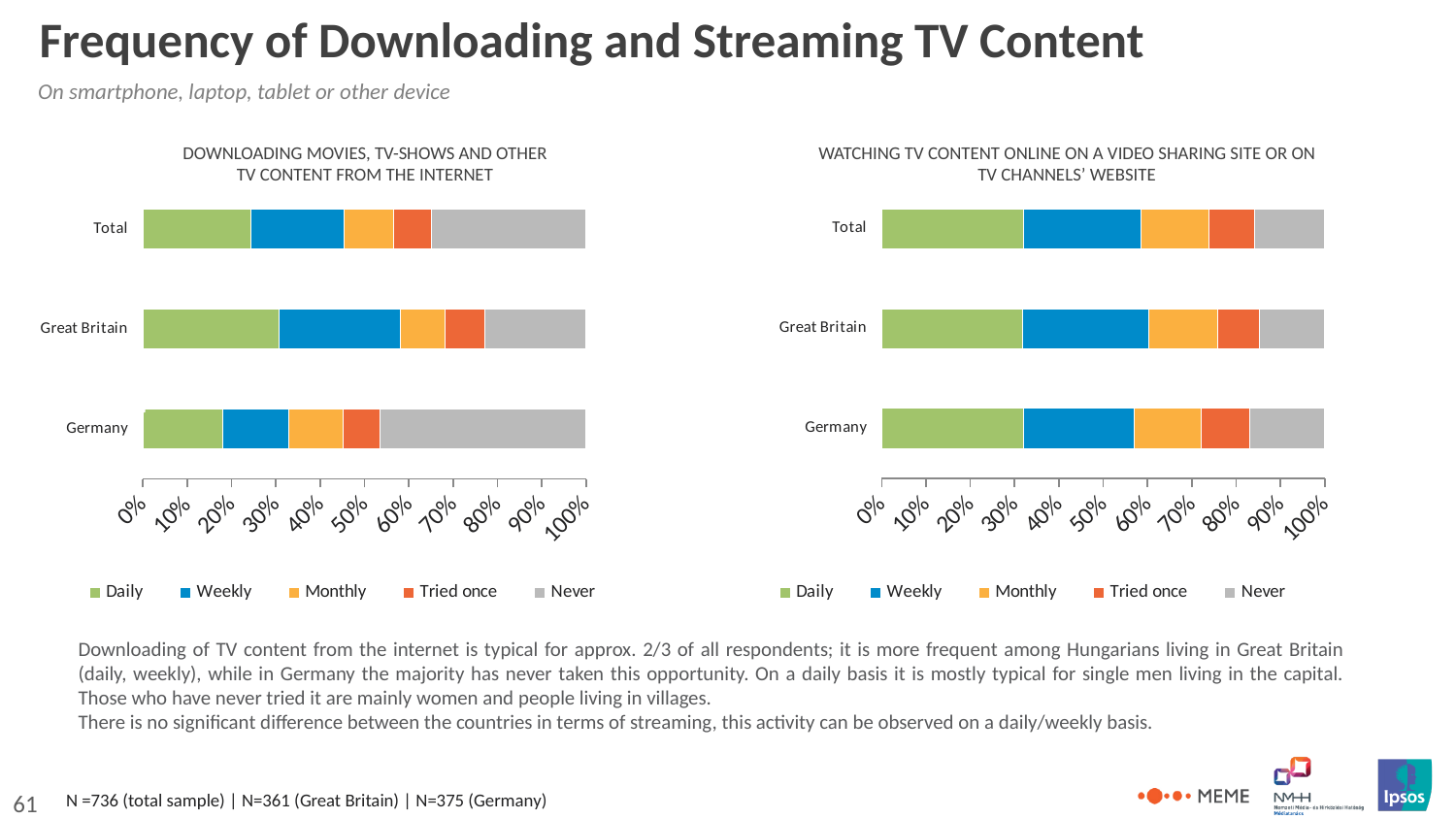
In the left chart, 'Downloading movies, TV-shows and other TV content from the internet', is the Daily share for Great Britain larger or smaller than the Daily share for Germany? Larger In the left chart, 'Downloading movies, TV-shows and other TV content from the internet', which category has the smallest Daily share? Germany In the left chart, 'Downloading movies, TV-shows and other TV content from the internet', which category has the largest Never share? Germany In the right chart, 'Watching TV content online on a video sharing site or on TV channels' website', is the Never share for Germany greater or less than 30%? less In the right chart, 'Watching TV content online on a video sharing site or on TV channels' website', is the Daily share for Total greater or less than 20%? greater In the left chart, 'Downloading movies, TV-shows and other TV content from the internet', is the Never share for Germany greater or less than 40%? greater How many series does the legend of the right chart, 'Watching TV content online on a video sharing site or on TV channels' website', list? 5 In the left chart, 'Downloading movies, TV-shows and other TV content from the internet', which category has the largest Daily share? Great Britain Which legend entry is shown in grey on both charts? Never What kind of chart is the left chart, 'Downloading movies, TV-shows and other TV content from the internet'? Stacked bar chart How many categories are shown on the left chart, 'Downloading movies, TV-shows and other TV content from the internet'? 3